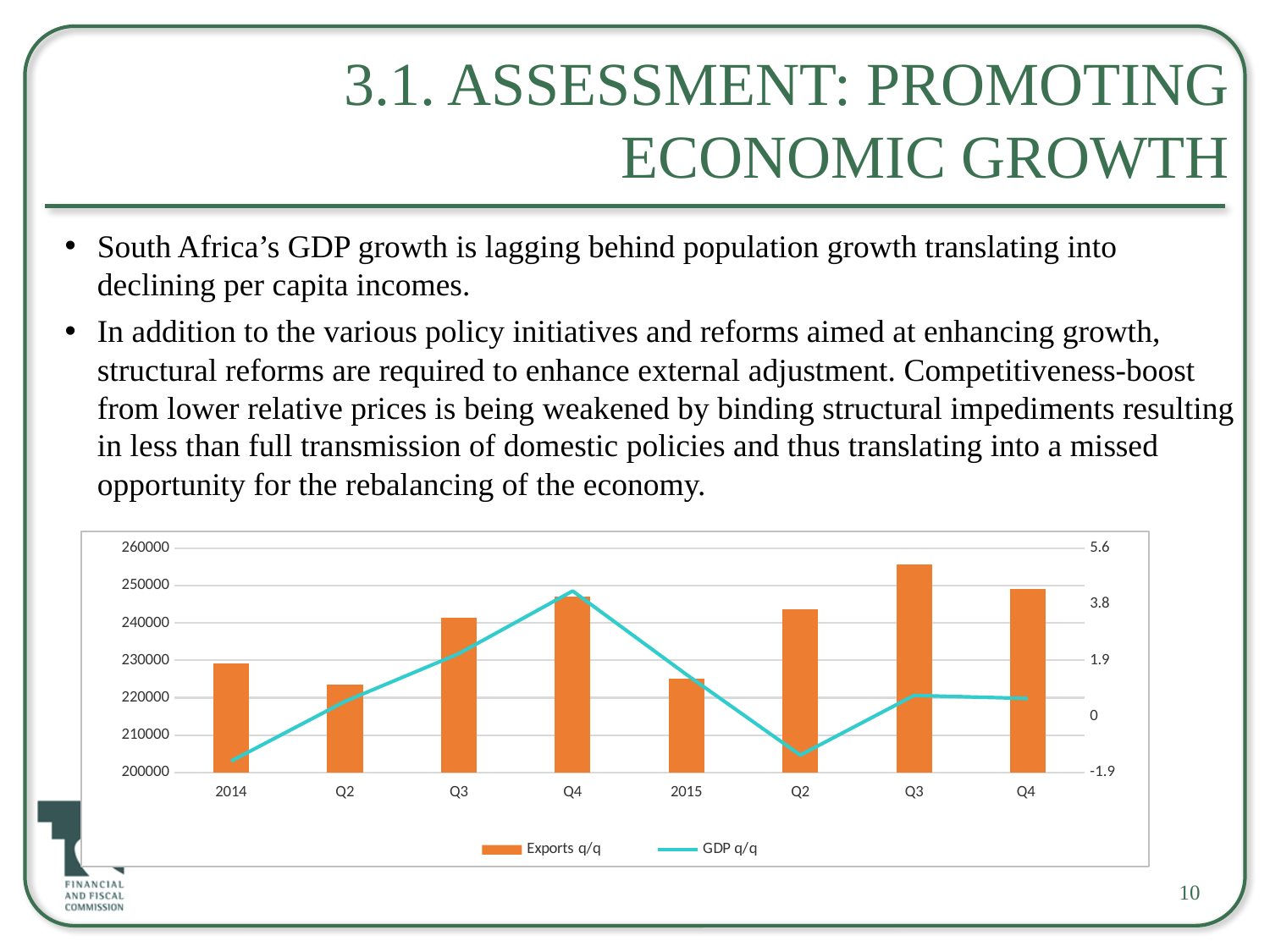
What are the two series named in the chart legend? Exports q/q and GDP q/q How many series does the chart legend list? 2 Which is larger, the Exports q/q bar for Q3 2014 or for 2015 (Q1)? Q3 2014 Is the Exports q/q value for 2015 (Q1) greater or less than 230000? less At which category does the GDP q/q line reach its highest point? Q4 (2014) Is the GDP q/q value for Q2 2015 greater or less than 0? less What type of chart is shown on the slide? A combined bar and line chart Is the GDP q/q value for Q4 2014 greater or less than 3.8? greater How many categories are shown along the x axis of the chart? 8 Which category has the highest Exports q/q bar? Q3 (2015) Does the GDP q/q line rise or fall from 2014 (Q1) to Q4 2014? Rises